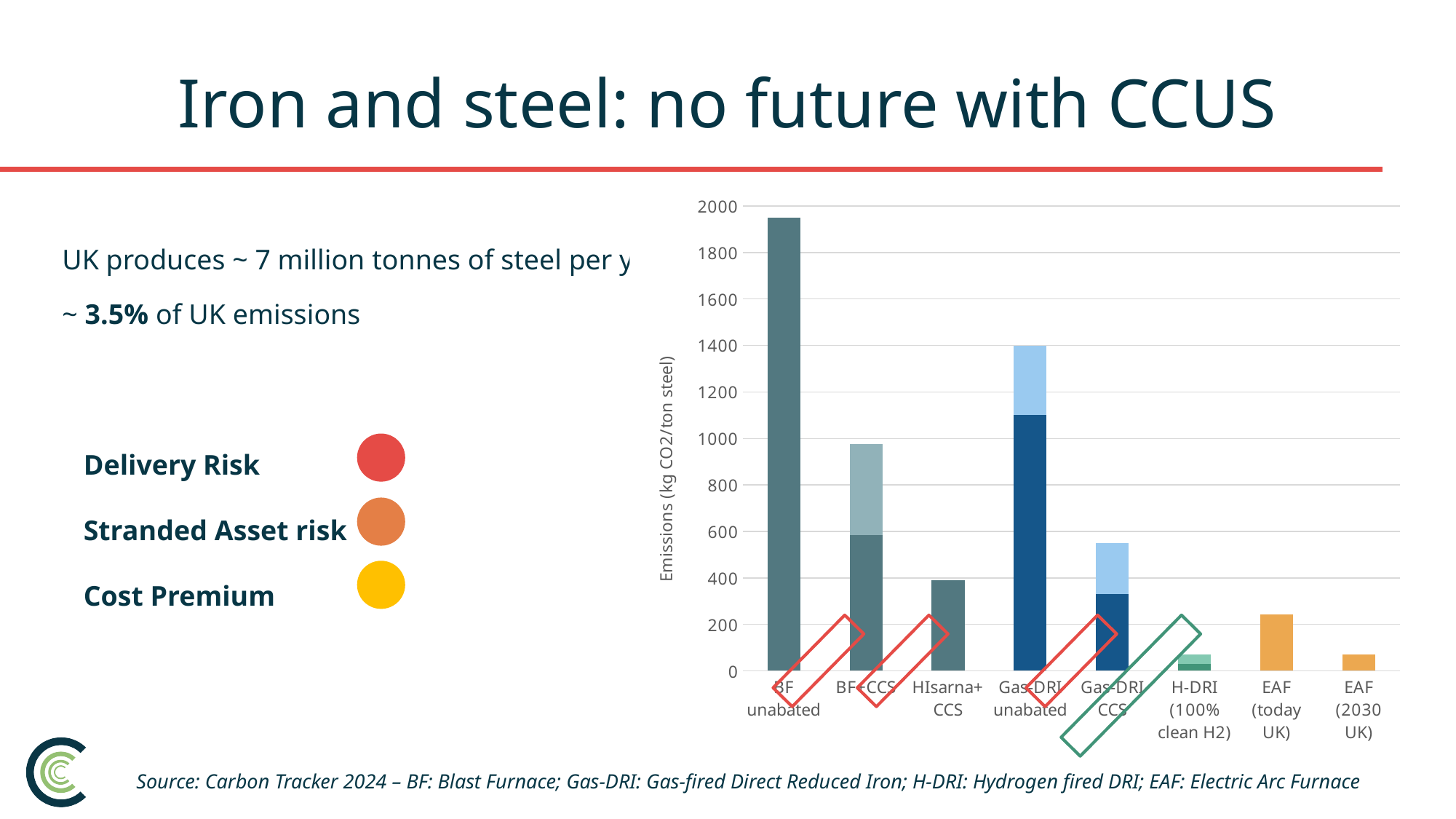
How many categories are shown on the x axis of the chart? 8 Which is larger, the value for EAF (today UK) or the value for EAF (2030 UK)? EAF (today UK) Is the total value for BF+CCS greater or less than 1200? less Is the value for H-DRI (100% clean H2) greater or less than 200? less What is the label on the y axis of the chart? Emissions (kg CO2/ton steel) Is the value for BF unabated greater or less than 1800? greater Which category has the highest emissions in the chart? BF unabated Which is larger, the value for BF unabated or the total for Gas-DRI unabated? BF unabated What kind of chart is shown on the slide? bar chart